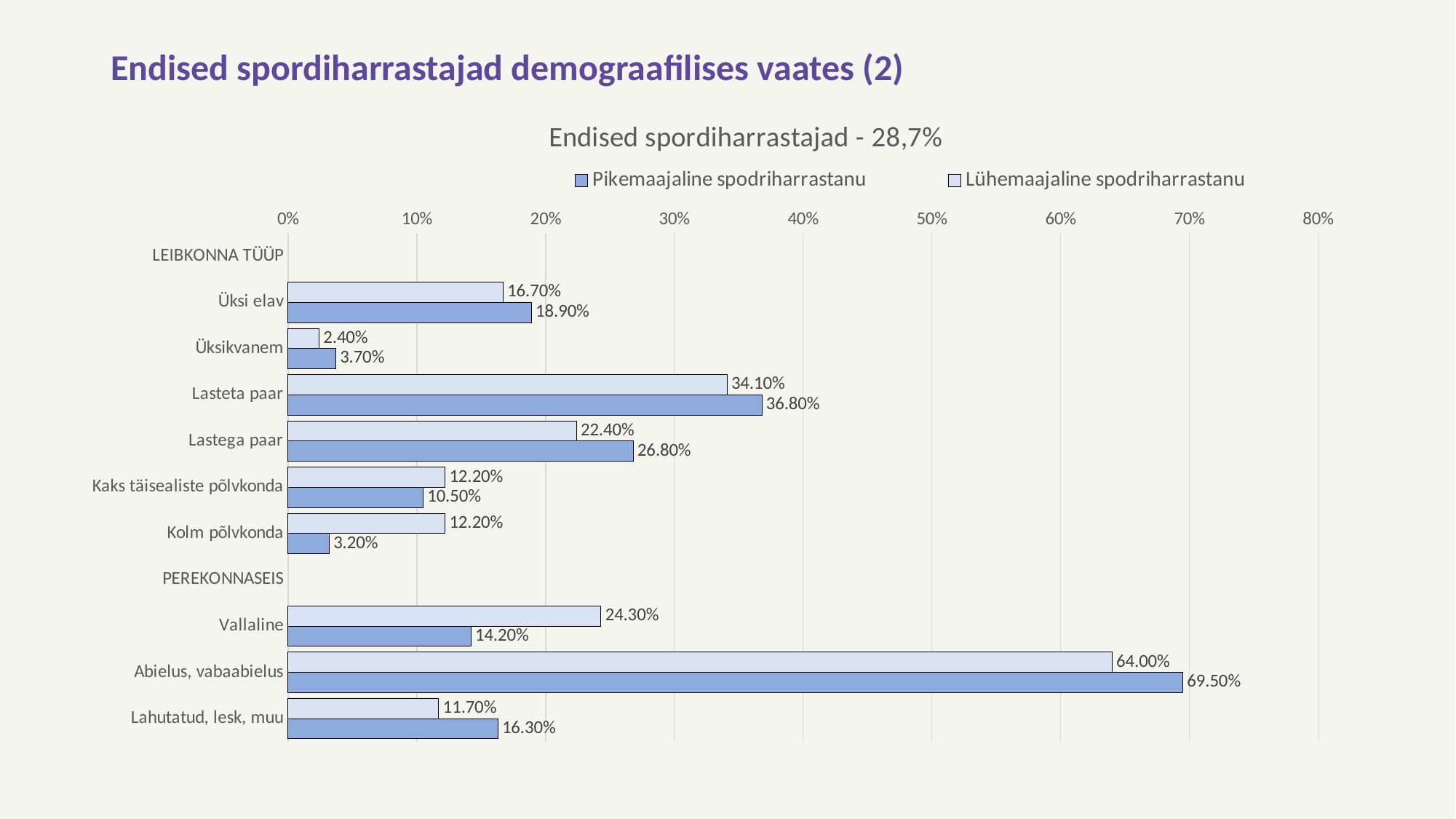
What is the value for Lastega paar in the Pikemaajaline spodriharrastanu series? 26.80% Which category has the lowest value in the Pikemaajaline spodriharrastanu series? Kolm põlvkonda What is the difference between the Pikemaajaline and Lühemaajaline values for Vallaline? 10.10% What is the title of the chart? Endised spordiharrastajad - 28,7% What is the value for Kolm põlvkonda in the Lühemaajaline spodriharrastanu series? 12.20% Which category has the highest value in the Lühemaajaline spodriharrastanu series? Abielus, vabaabielus How many series does the legend list? 2 What is the value for Abielus, vabaabielus in the Pikemaajaline spodriharrastanu series? 69.50% For Kaks täisealiste põlvkonda, which series has the larger value: Pikemaajaline spodriharrastanu or Lühemaajaline spodriharrastanu? Lühemaajaline spodriharrastanu Is the Pikemaajaline spodriharrastanu value for Lasteta paar greater or less than 30%? greater What is the difference between the Pikemaajaline and Lühemaajaline values for Üksikvanem? 1.30% What kind of chart is shown on the slide? Bar chart